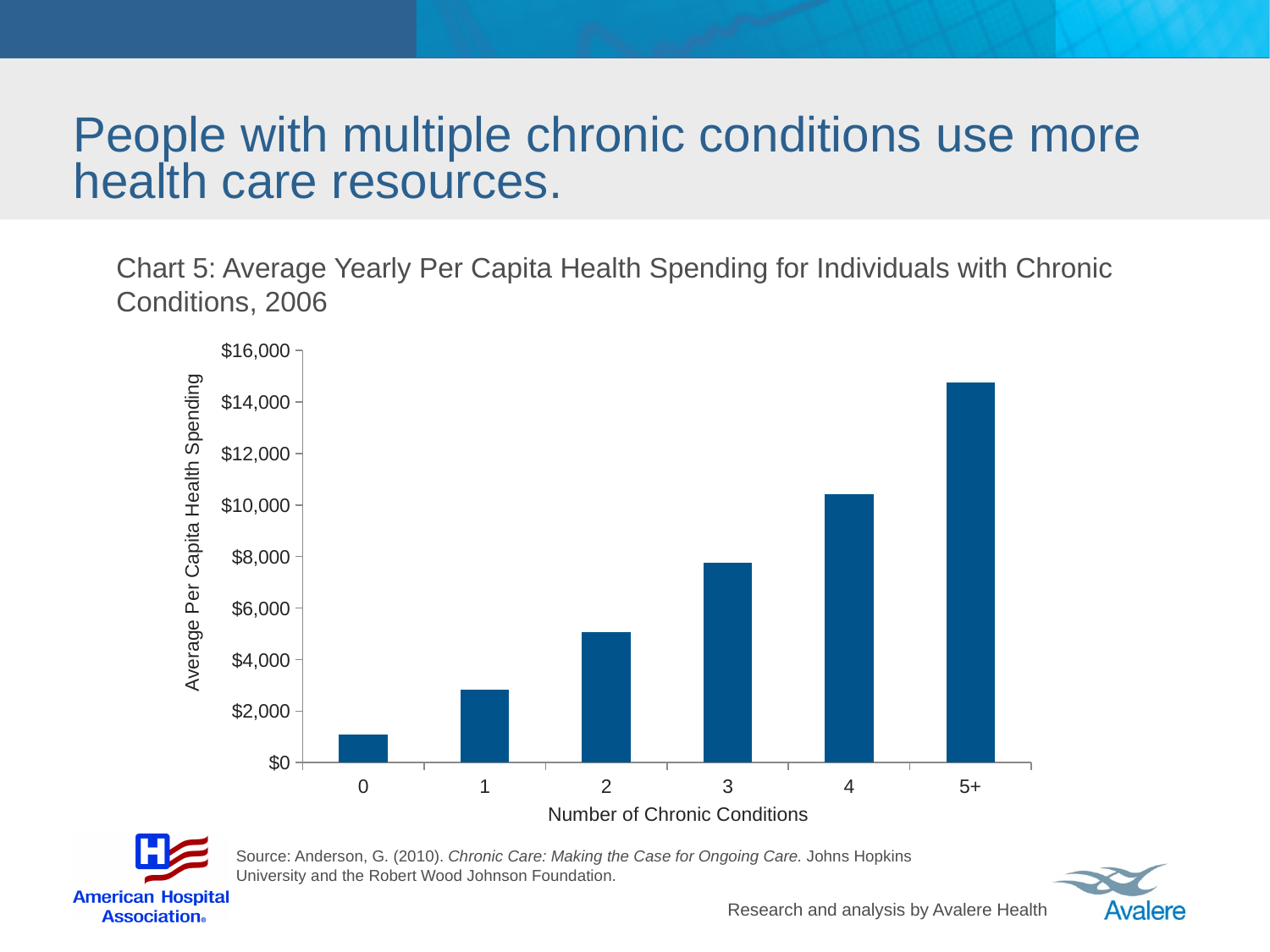
Is the average per capita health spending for people with 4 chronic conditions greater or less than $10,000? greater What kind of chart is shown on the slide? Bar chart Which has higher average per capita health spending: people with 2 chronic conditions or people with 4 chronic conditions? 4 chronic conditions Is the average per capita health spending for people with 1 chronic condition greater or less than $4,000? less Which number of chronic conditions has the lowest average per capita health spending? 0 Is the average per capita health spending for people with 0 chronic conditions greater or less than $2,000? less What is the label of the y axis of the chart? Average Per Capita Health Spending Do the values rise or fall as the number of chronic conditions increases along the x axis? Rise How many categories are shown on the x axis of the chart? 6 Which number of chronic conditions has the highest average per capita health spending? 5+